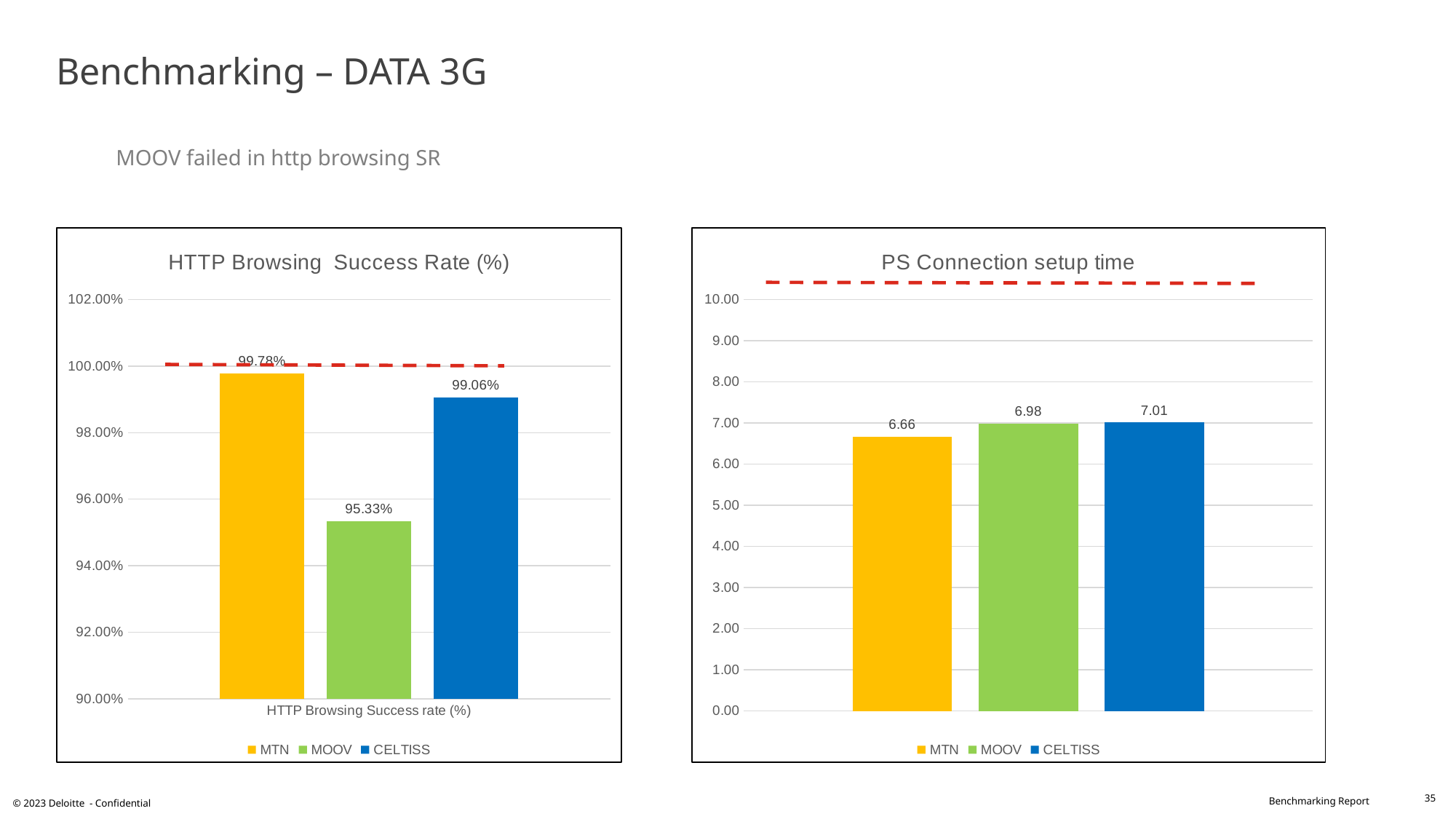
In the HTTP Browsing Success Rate (%) chart, what is the difference between the MTN and MOOV values? 4.45% In the PS Connection setup time chart, which is larger, the value for MTN or the value for CELTISS? CELTISS How many series does the legend of the PS Connection setup time chart list? 3 In the PS Connection setup time chart, which operator has the lowest setup time? MTN In the HTTP Browsing Success Rate (%) chart, which operator has the highest success rate? MTN In the HTTP Browsing Success Rate (%) chart, which operator has the lowest success rate? MOOV In the HTTP Browsing Success Rate (%) chart, what is the value for MTN? 99.78% In the HTTP Browsing Success Rate (%) chart, what is the value for MOOV? 95.33% In the PS Connection setup time chart, what is the value for CELTISS? 7.01 What kind of chart is the HTTP Browsing Success Rate (%) chart? bar chart In the HTTP Browsing Success Rate (%) chart, is the value for MOOV greater or less than 96.00%? less In the PS Connection setup time chart, what is the value for MTN? 6.66